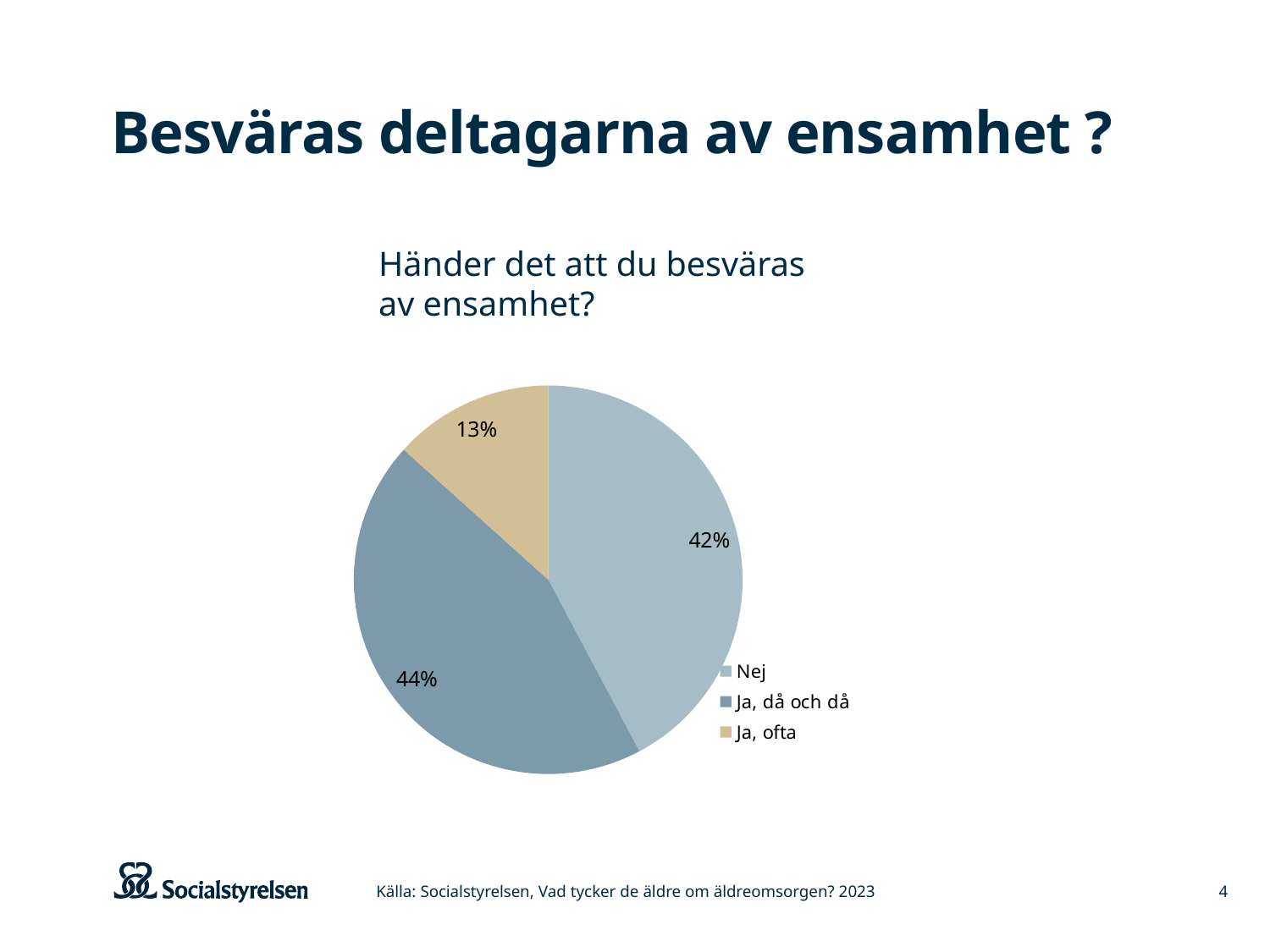
Which slice of the pie is the smallest? Ja, ofta What is the difference in percentage points between the "Nej" slice and the "Ja, ofta" slice? 29 Which is larger, the "Nej" slice or the "Ja, ofta" slice? Nej How many entries does the legend list? 3 What share of the pie is labelled "Ja, ofta"? 13% What is the title of the chart? Händer det att du besväras av ensamhet? What kind of chart is shown on the slide? pie chart What share of the pie is labelled "Nej"? 42% What share of the pie is labelled "Ja, då och då"? 44% Which legend entry is shown in the tan/beige colour? Ja, ofta How many slices does the pie chart have? 3 What is the difference in percentage points between the "Ja, då och då" slice and the "Ja, ofta" slice? 31